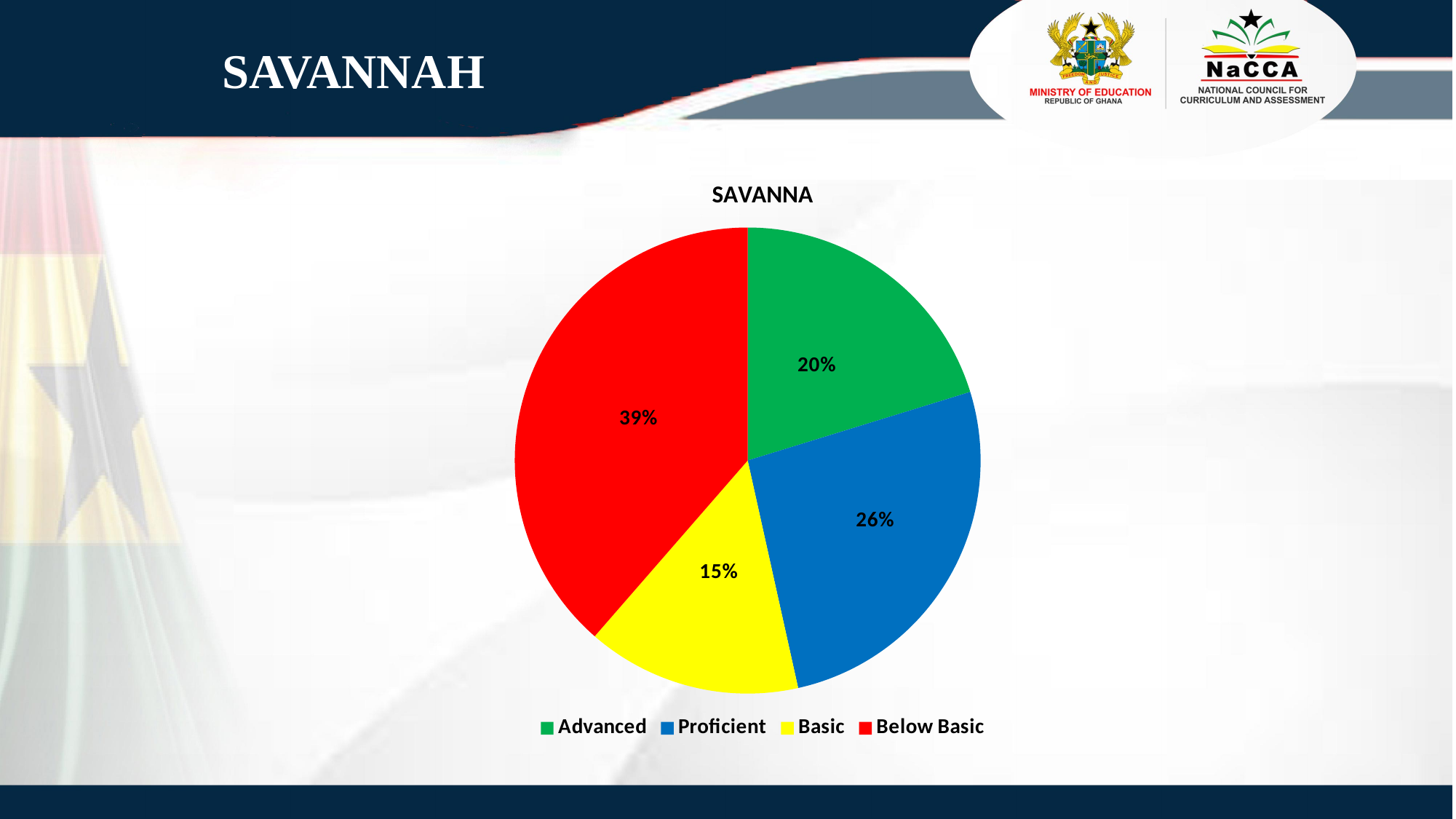
What percentage of the pie is labelled Basic? 15% Which category has the smallest slice of the pie? Basic What percentage of the pie is labelled Advanced? 20% What is the title of the chart? SAVANNA What kind of chart is shown on the slide? Pie chart Which slice is larger, Proficient or Basic? Proficient Which category has the largest slice of the pie? Below Basic What colour is the Below Basic slice? Red What percentage of the pie is labelled Below Basic? 39% What percentage of the pie is labelled Proficient? 26% How many categories does the pie chart show? 4 What is the difference in percentage points between the Below Basic and Advanced slices? 19